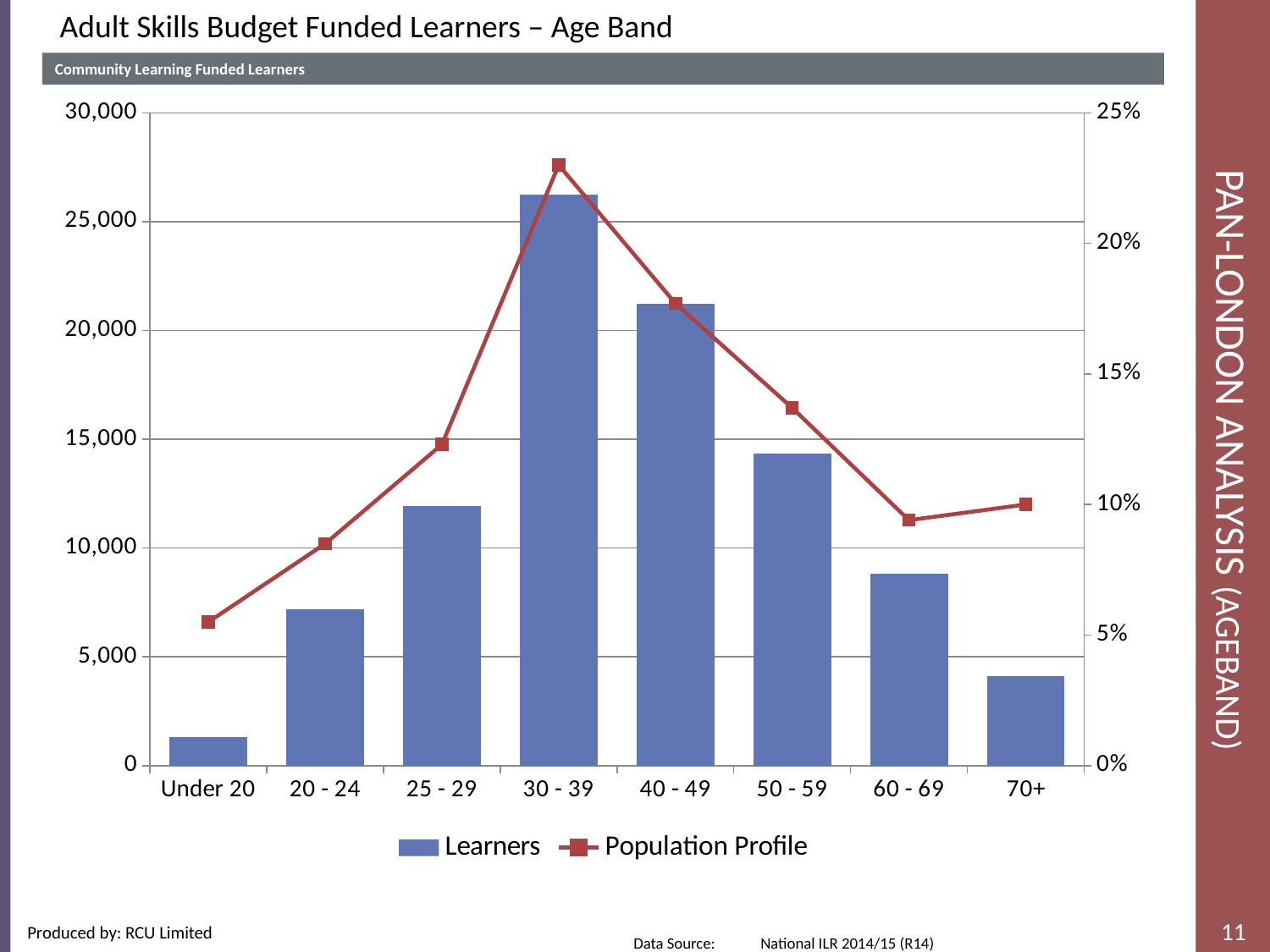
Which age band has the highest number of Learners? 30 - 39 Which age band has the lowest number of Learners? Under 20 Is the Learners value for the 50 - 59 age band greater or less than 15,000? less Is the Population Profile value for the 30 - 39 age band greater or less than 20%? greater How many series does the legend list? 2 Which age band has more Learners, 40 - 49 or 50 - 59? 40 - 49 Is the Population Profile value for the 20 - 24 age band greater or less than 10%? less How many age bands are shown on the x axis? 8 Which series is plotted as a line with square markers? Population Profile What kind of chart is shown on the slide? Combined bar and line chart